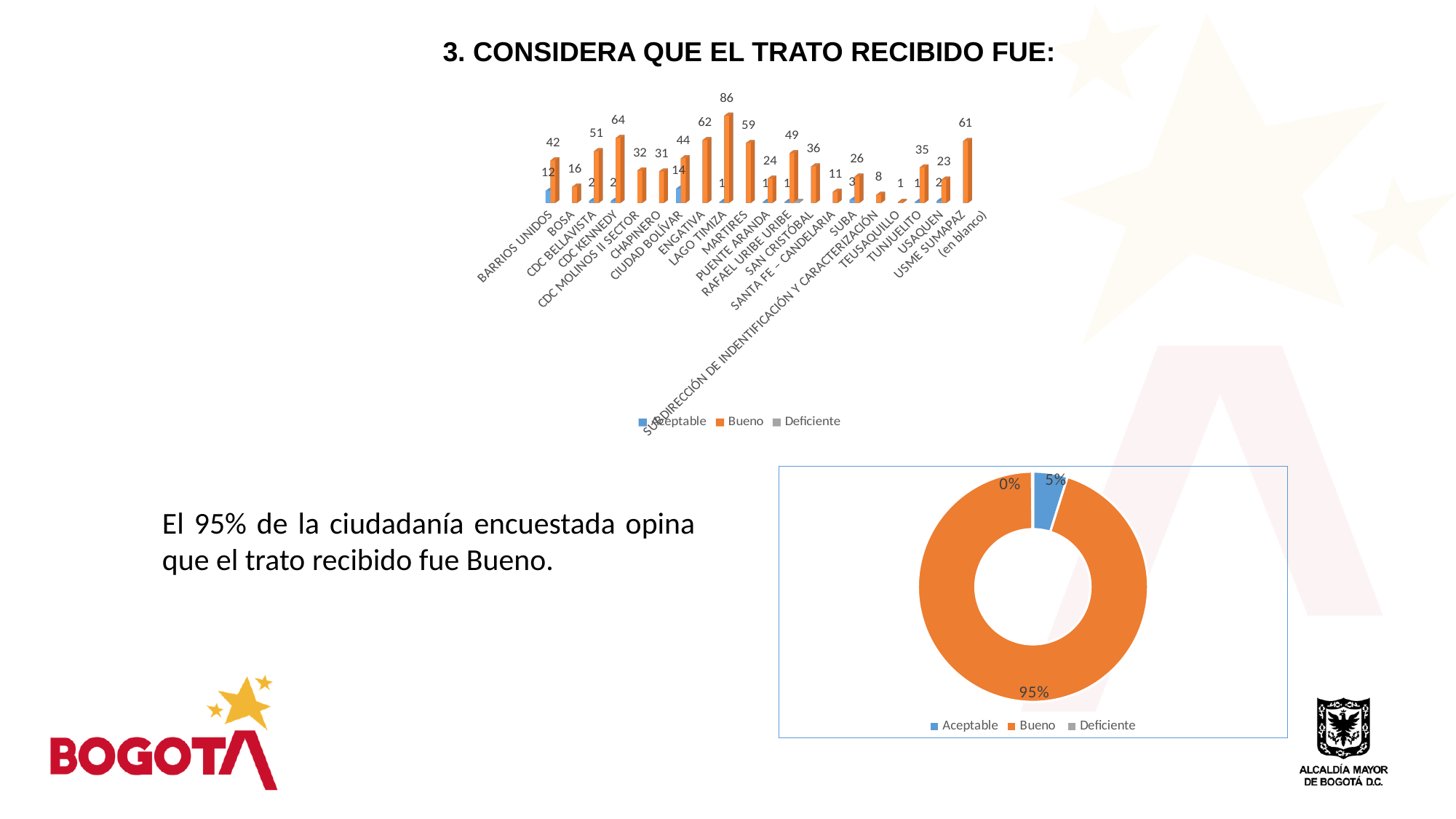
In the top bar chart, which has the larger Bueno value, BARRIOS UNIDOS or BOSA? BARRIOS UNIDOS In the top bar chart, what are the three series named in the legend? Aceptable, Bueno, Deficiente What kind of chart is the top chart titled '3. CONSIDERA QUE EL TRATO RECIBIDO FUE:'? Bar chart In the top bar chart, which category has the highest Bueno value? LAGO TIMIZA In the top bar chart, what is the highest Bueno value shown? 86 In the bottom-right doughnut chart, what is the difference in percentage points between the Bueno and Aceptable shares? 90 percentage points In the top bar chart, how many series does the legend list? 3 In the top bar chart, what is the Aceptable value for BARRIOS UNIDOS? 12 In the bottom-right doughnut chart, what share does Bueno have? 95% What kind of chart is the chart at the bottom right of the slide? Doughnut chart In the top bar chart, what is the Bueno value for BARRIOS UNIDOS? 42 In the bottom-right doughnut chart, what share does Aceptable have? 5%